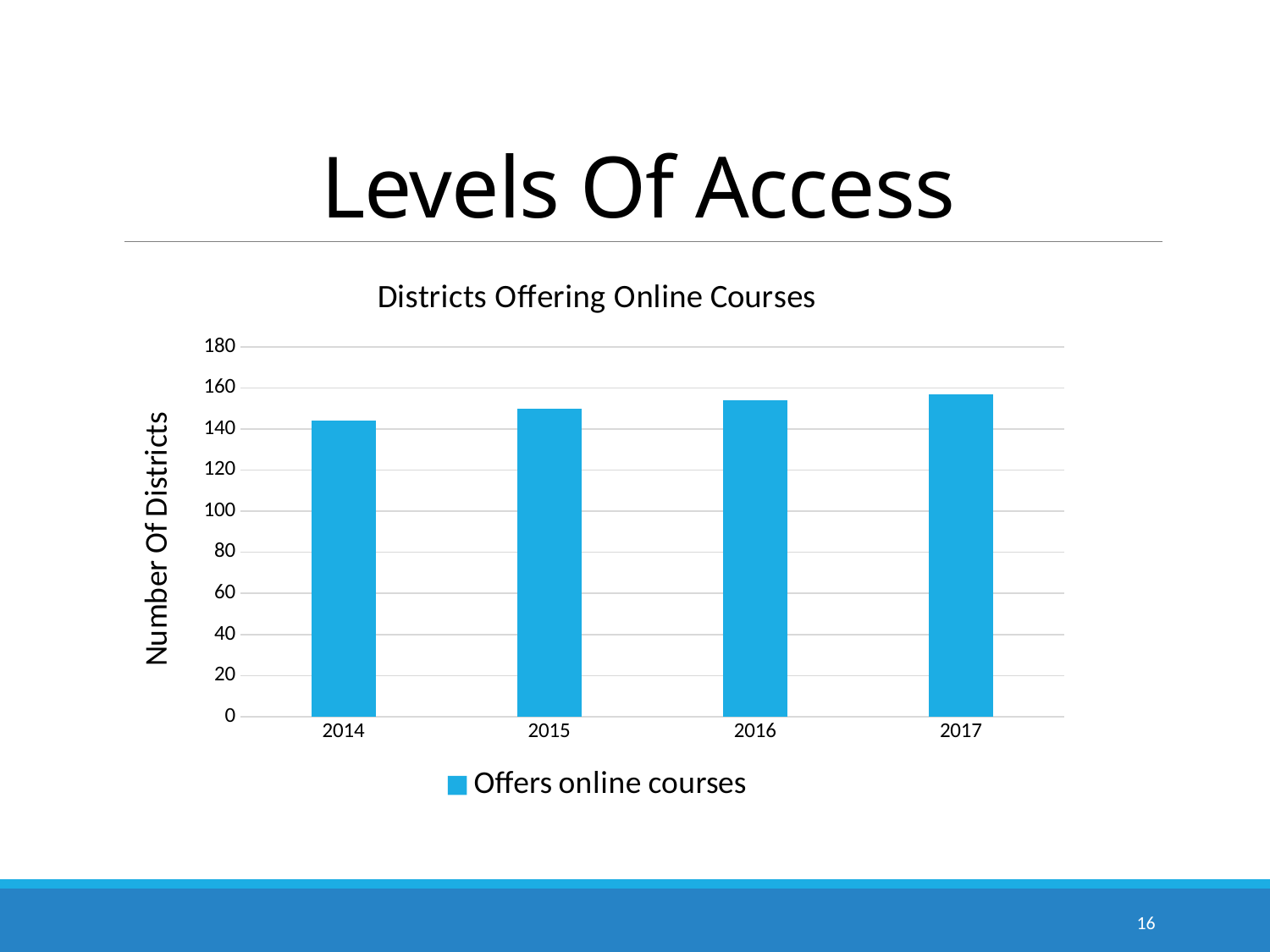
What is the label on the vertical axis of the chart? Number Of Districts Which year has more districts offering online courses, 2014 or 2017? 2017 Is the value for 2014 greater or less than 160? less How many series does the legend list? 1 Which year has the lowest number of districts offering online courses? 2014 What kind of chart is shown on the slide? Bar chart Do the values rise or fall from 2014 to 2017? Rise Which year has the highest number of districts offering online courses? 2017 Is the value for 2017 greater or less than 180? less How many years are shown on the x axis of the chart? 4 What is the title of the chart? Districts Offering Online Courses Is the value for 2016 greater or less than 140? greater